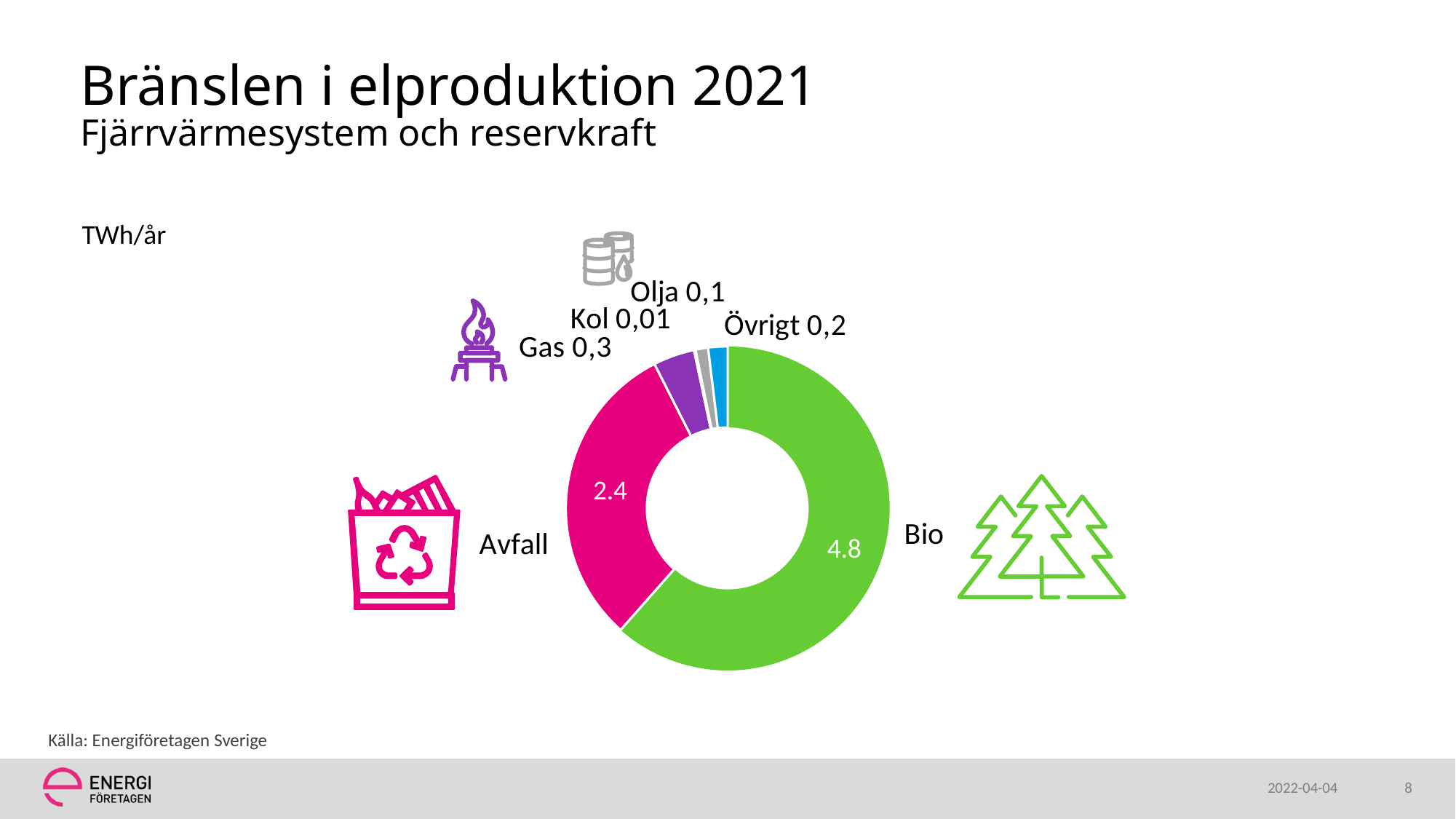
What unit is stated for the values in the chart? TWh/år Which is larger, the value for Olja or the value for Övrigt? Övrigt What is the value for Avfall? 2.4 What type of chart is shown on the slide? Pie (donut) chart How many categories are shown in the chart? 6 What is the difference between the values for Bio and Avfall? 2.4 Which category has the smallest value? Kol Which category has the largest slice? Bio What is the value for Bio? 4.8 What is the value for Kol? 0,01 What is the value for Övrigt? 0,2 What is the value for Gas? 0,3